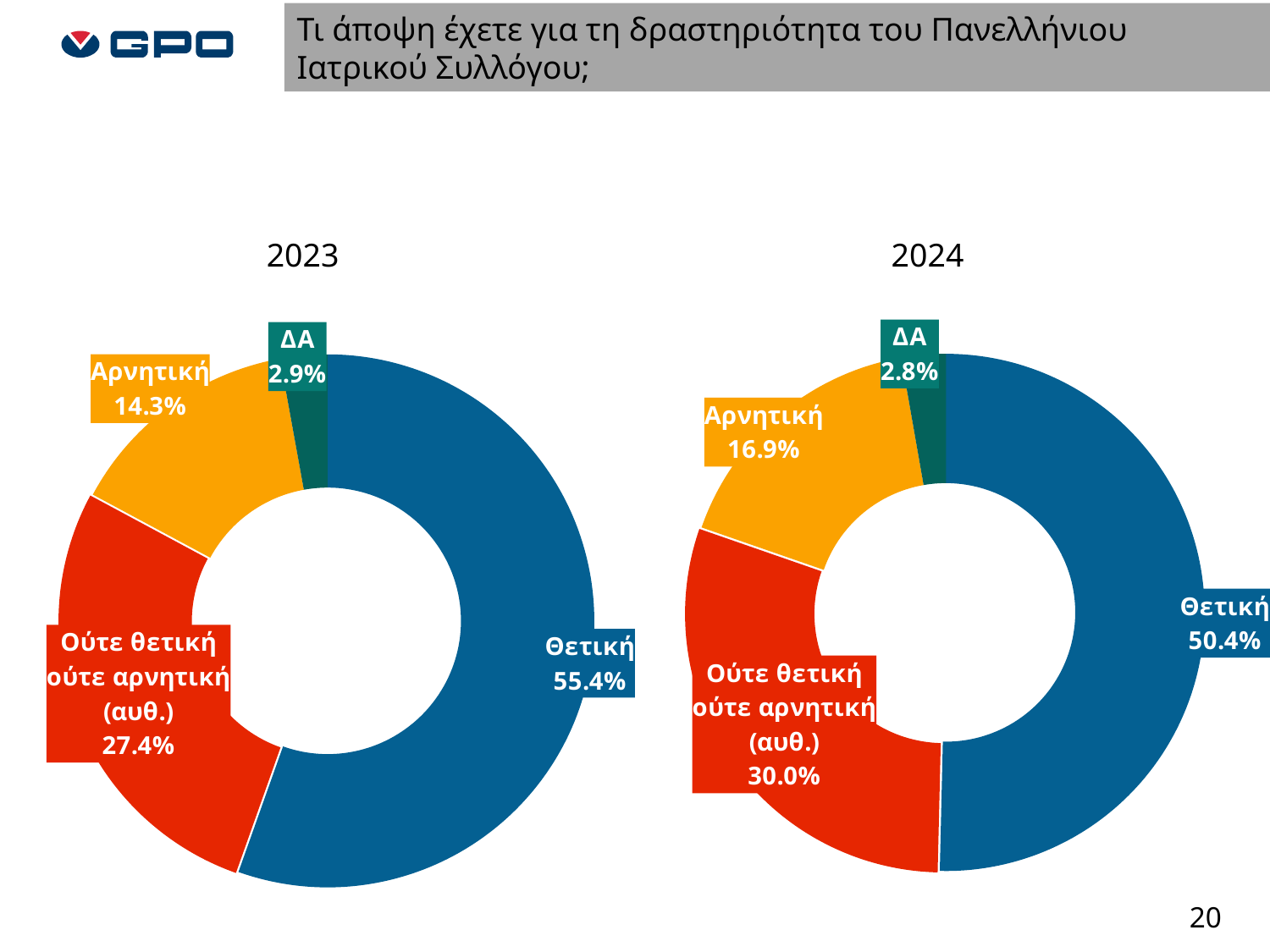
What is the difference between the Θετική value in the 2023 chart and the Θετική value in the 2024 chart? 5.0% Is the Αρνητική share larger in the 2023 chart or the 2024 chart? 2024 In the 2024 chart, what is the value for Αρνητική? 16.9% In the 2023 chart, what is the value for Θετική? 55.4% In the 2023 chart, what is the difference between Ούτε θετική ούτε αρνητική (αυθ.) and Αρνητική? 13.1% In the 2023 chart, what is the value for ΔΑ? 2.9% In the 2024 chart, what is the value for Ούτε θετική ούτε αρνητική (αυθ.)? 30.0% In the 2023 chart, which category has the largest share? Θετική What colour is the Θετική slice in both charts? Blue In the 2024 chart, which category has the smallest share? ΔΑ How many categories does the 2024 chart show? 4 What kind of chart is the 2023 chart? Doughnut (pie) chart